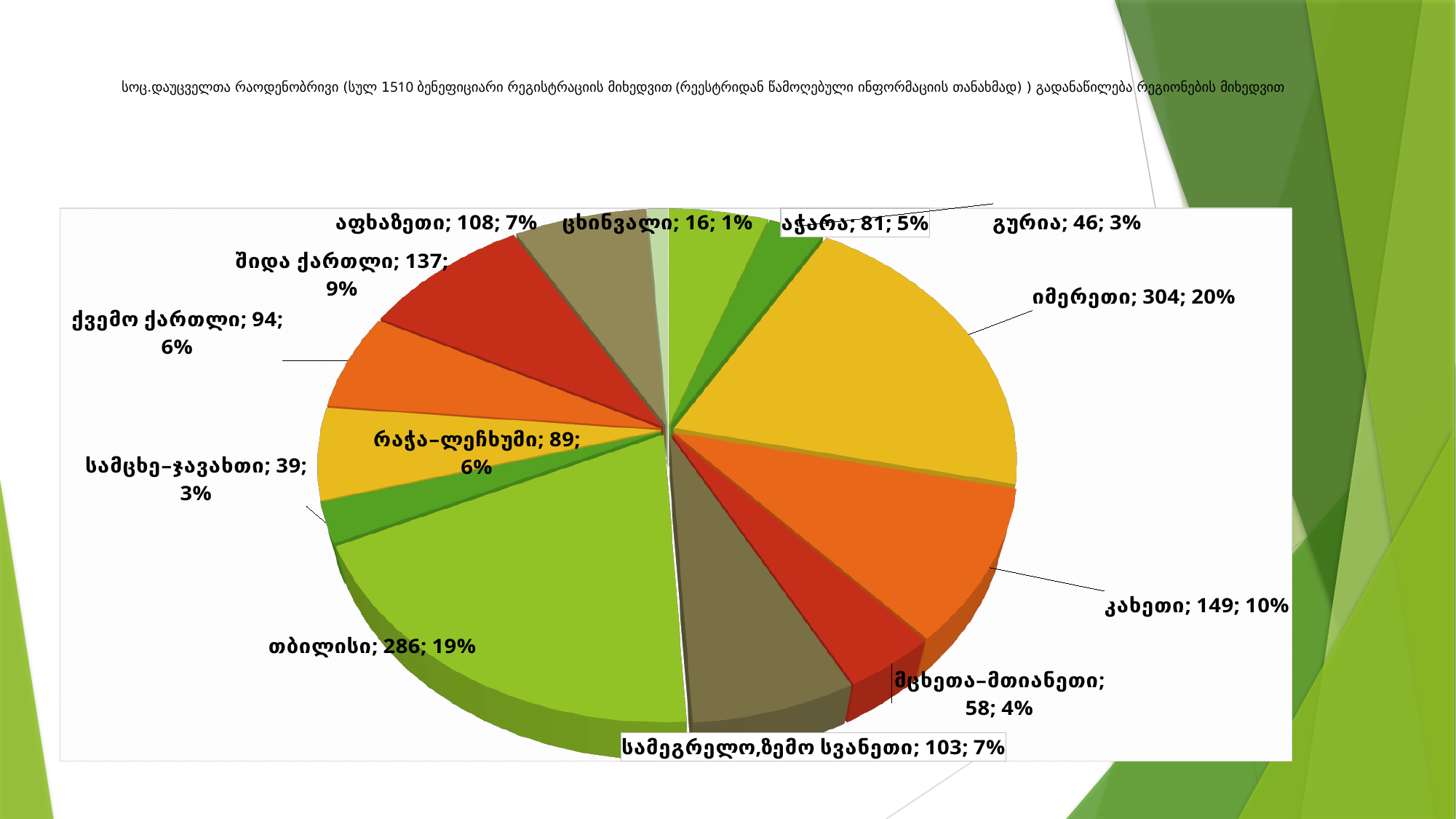
What is the difference between the values for იმერეთი and თბილისი? 18 What is the value for კახეთი? 149 Which region has the largest slice? იმერეთი How many slices (regions) does the pie chart have? 13 What is the value for თბილისი? 286 Which region has the smallest slice? ცხინვალი What is the value for იმერეთი? 304 What share of the pie does შიდა ქართლი represent? 9% What share of the pie does მცხეთა-მთიანეთი represent? 4% What is the value for სამცხე-ჯავახეთი? 39 Which is larger, the value for აფხაზეთი or the value for სამეგრელო,ზემო სვანეთი? აფხაზეთი What kind of chart is shown on the slide? pie chart